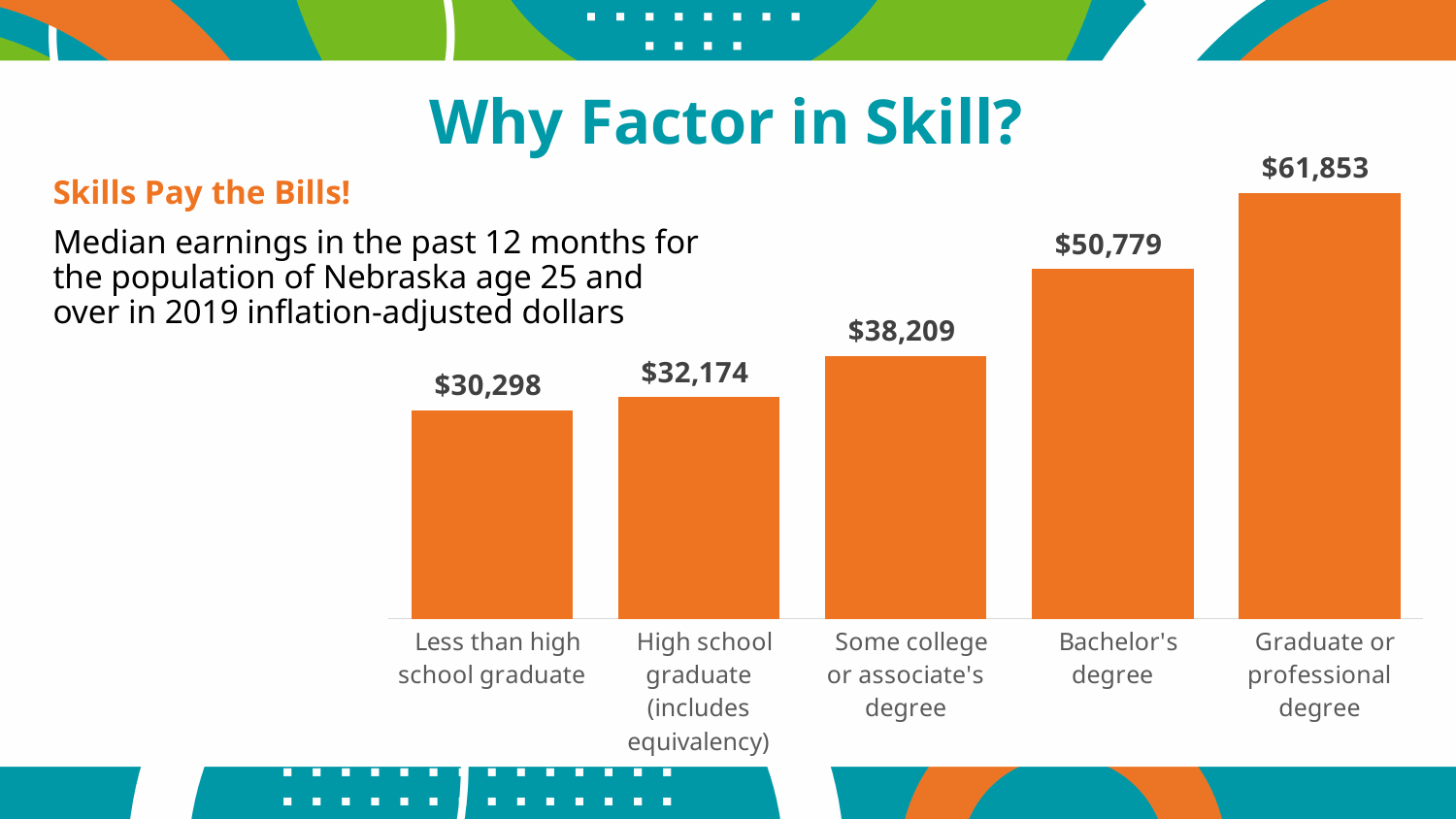
What kind of chart is shown on the slide? Bar chart Which has higher median earnings: Some college or associate's degree or High school graduate (includes equivalency)? Some college or associate's degree Which education level has the highest median earnings? Graduate or professional degree What is the difference in median earnings between High school graduate (includes equivalency) and Less than high school graduate? $1,876 What is the median earnings value for Some college or associate's degree? $38,209 What colour are the bars in the chart? Orange Do median earnings rise or fall as education level increases from left to right? Rise What is the difference in median earnings between Graduate or professional degree and Bachelor's degree? $11,074 Which education level has the lowest median earnings? Less than high school graduate What is the median earnings value for Bachelor's degree? $50,779 How many education categories are shown in the chart? 5 What is the median earnings value for Less than high school graduate? $30,298